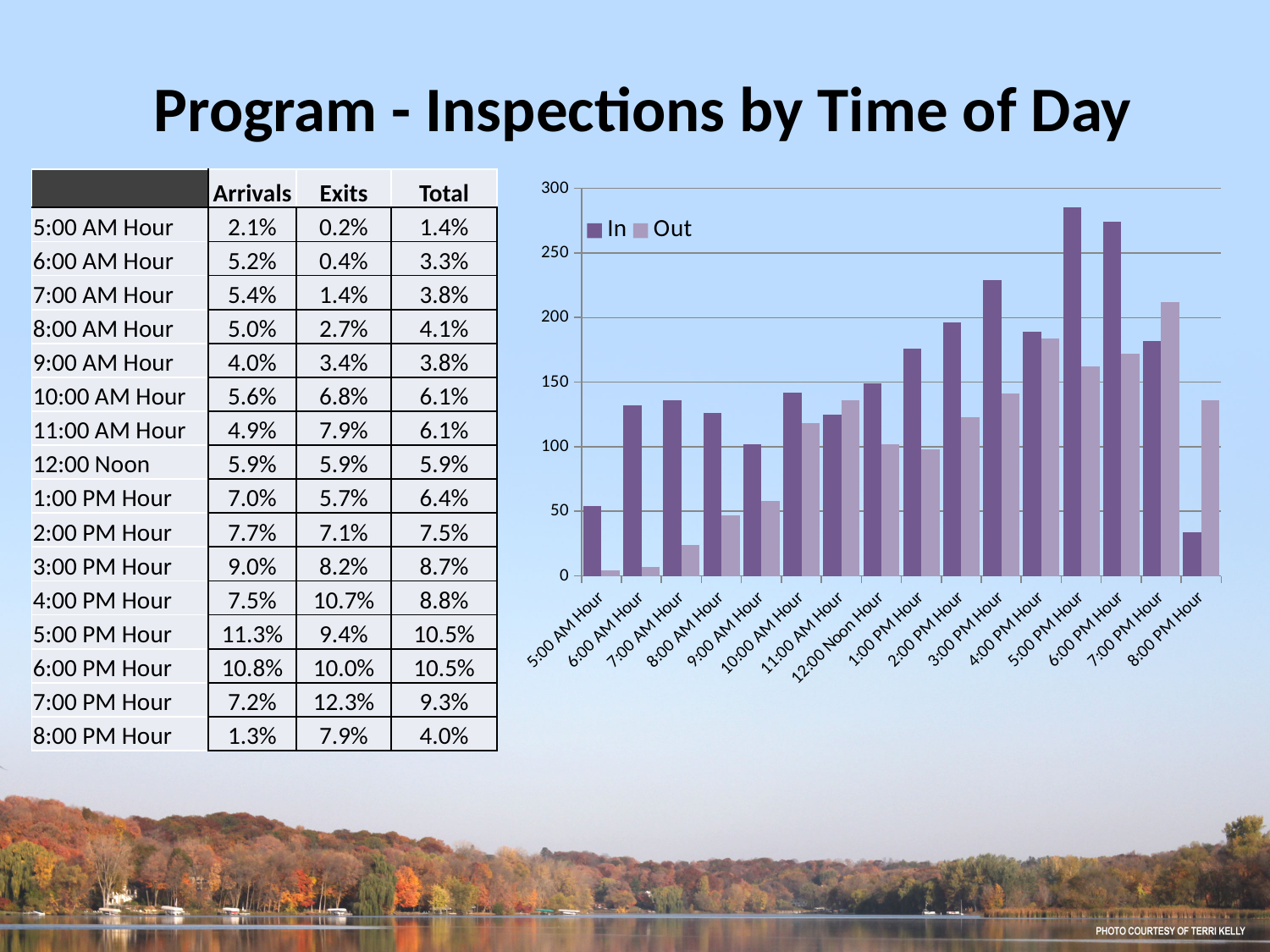
What are the two series named in the chart's legend? In and Out Which category has the highest Out value on the chart? 7:00 PM Hour How many time-of-day categories are plotted on the chart's x axis? 16 How many series does the chart's legend list? 2 Is the In value for 8:00 PM Hour greater or less than 50? less Which category has the highest In value on the chart? 5:00 PM Hour Which category has the lowest In value on the chart? 8:00 PM Hour For 8:00 AM Hour, which is larger on the chart, the In value or the Out value? In Is the Out value for 7:00 PM Hour greater or less than 200? greater For 7:00 PM Hour, which is larger on the chart, the In value or the Out value? Out Is the In value for 5:00 PM Hour greater or less than 250? greater What kind of chart is shown on the slide? bar chart